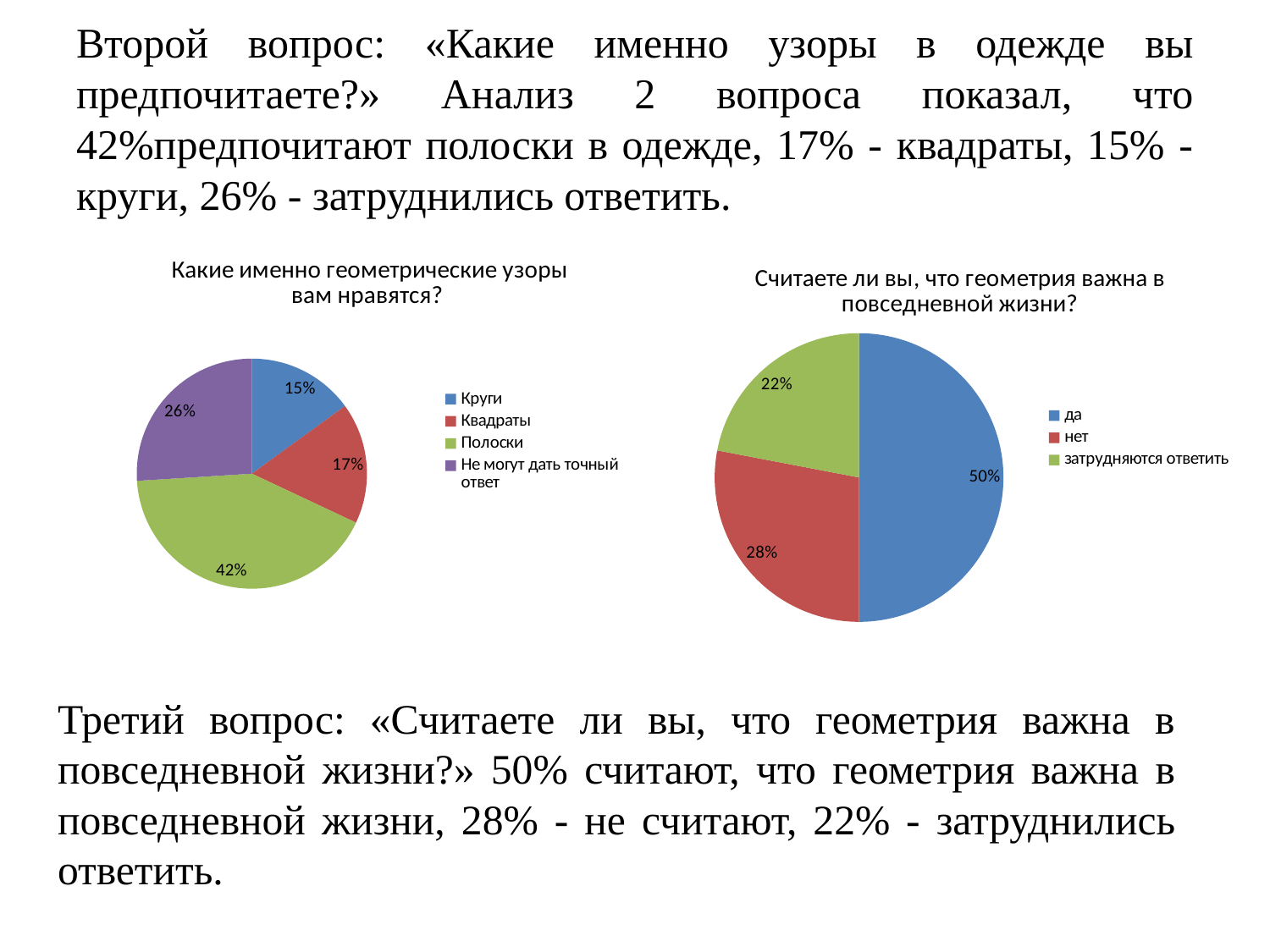
What type of chart is the right chart 'Считаете ли вы, что геометрия важна в повседневной жизни?'? pie chart In the right chart 'Считаете ли вы, что геометрия важна в повседневной жизни?', what colour is the slice for да? blue In the right chart 'Считаете ли вы, что геометрия важна в повседневной жизни?', which is larger, нет or затрудняются ответить? нет In the left chart 'Какие именно геометрические узоры вам нравятся?', what share is shown for Полоски? 42% In the left chart 'Какие именно геометрические узоры вам нравятся?', which category has the largest slice? Полоски In the left chart 'Какие именно геометрические узоры вам нравятся?', how many categories does the legend list? 4 In the right chart 'Считаете ли вы, что геометрия важна в повседневной жизни?', which category has the largest slice? да In the right chart 'Считаете ли вы, что геометрия важна в повседневной жизни?', what share is shown for затрудняются ответить? 22% In the left chart 'Какие именно геометрические узоры вам нравятся?', what is the difference in percentage points between Полоски and Квадраты? 25 In the left chart 'Какие именно геометрические узоры вам нравятся?', which category has the smallest slice? Круги In the right chart 'Считаете ли вы, что геометрия важна в повседневной жизни?', what share is shown for нет? 28% In the left chart 'Какие именно геометрические узоры вам нравятся?', what share is shown for Круги? 15%